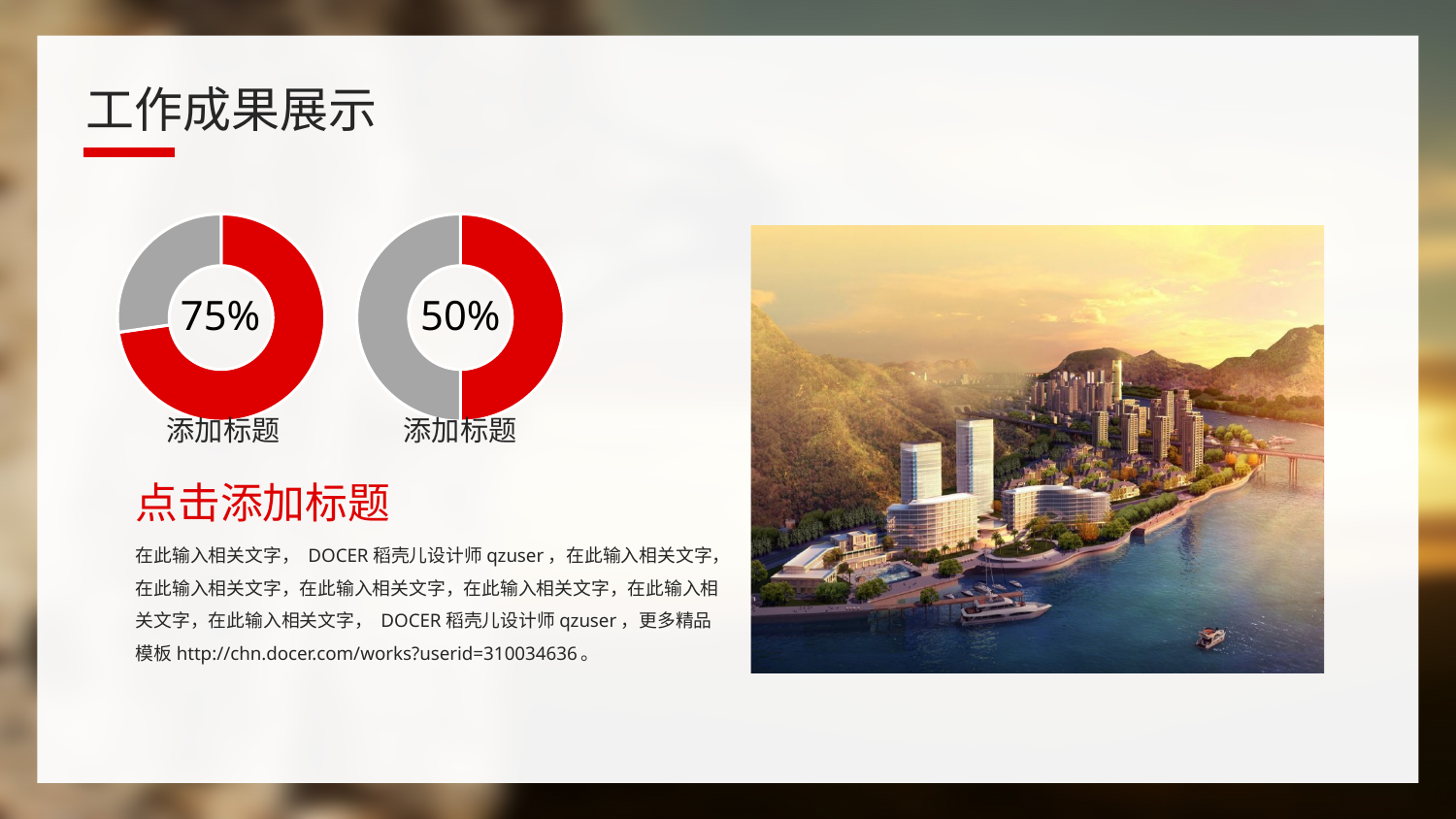
How many doughnut charts are shown on the slide? 2 Is the percentage shown in the left doughnut chart greater or less than 50%? greater In the right doughnut chart, what share of the ring is filled in red? 50% What percentage is shown in the centre of the left doughnut chart? 75% What is the difference between the percentages shown in the left and right doughnut charts? 25% What percentage is shown in the centre of the right doughnut chart? 50% How many segments does each doughnut chart have? 2 What kind of chart is used on the left side of the slide? Doughnut chart Which doughnut chart shows the larger percentage, the left one or the right one? The left one What colour is used for the highlighted (filled) portion of the doughnut charts? Red